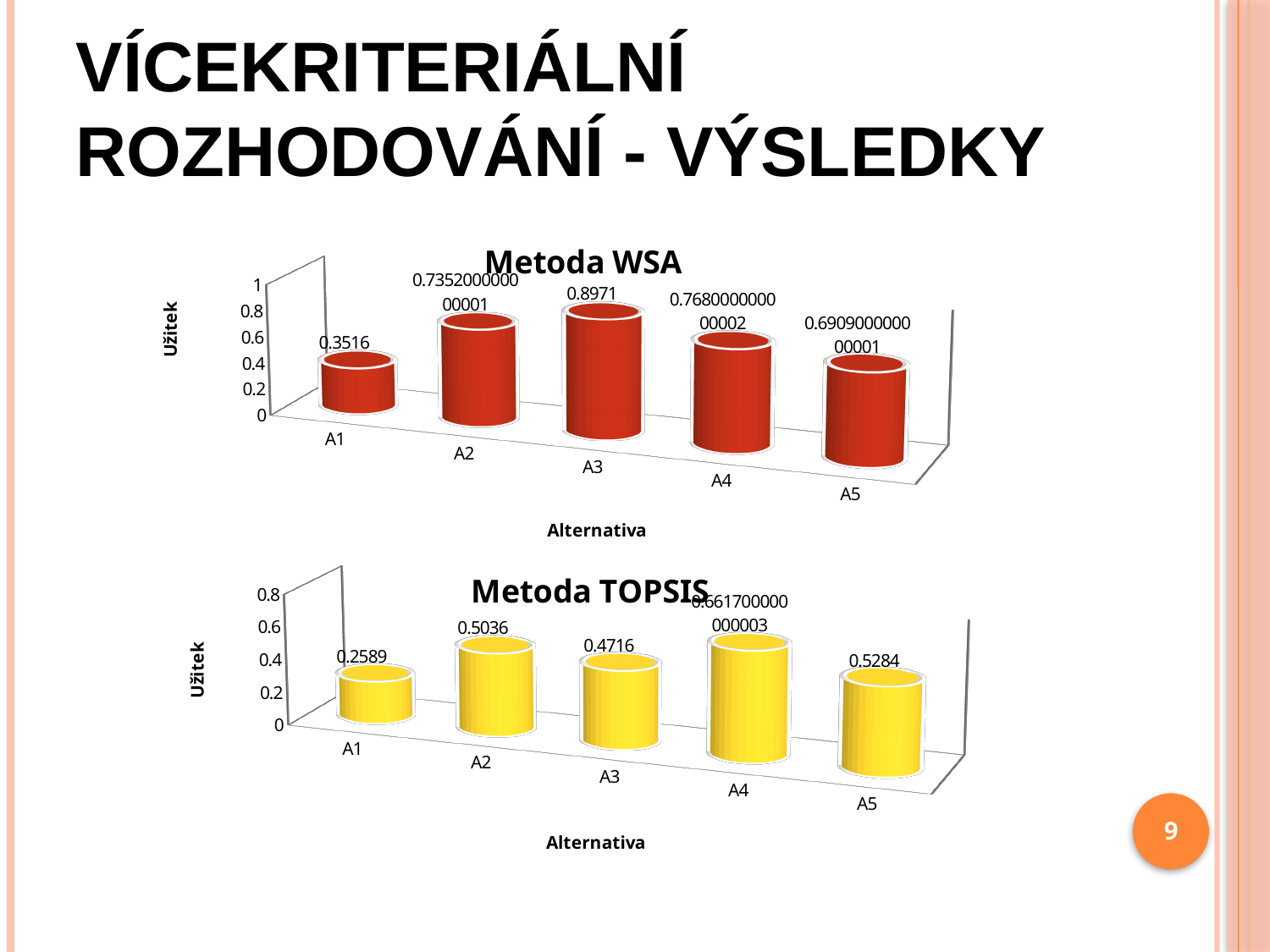
In the Metoda TOPSIS chart, what is the value for A2? 0.5036 In the Metoda WSA chart, which alternative has the lowest value? A1 In the Metoda TOPSIS chart, what is the difference between the values for A2 and A1? 0.2447 In the Metoda WSA chart, what is the value for A3? 0.8971 In the Metoda WSA chart, how many alternatives are shown on the x axis? 5 In the Metoda TOPSIS chart, which alternative has the highest value? A4 In the Metoda TOPSIS chart, which is larger, the value for A5 or the value for A1? A5 In the Metoda TOPSIS chart, what is the value for A5? 0.5284 In the Metoda WSA chart, what is the value for A1? 0.3516 In the Metoda WSA chart, what is the difference between the values for A3 and A1? 0.5455 In the Metoda WSA chart, which alternative has the highest value? A3 What kind of chart is the Metoda TOPSIS chart? Bar chart